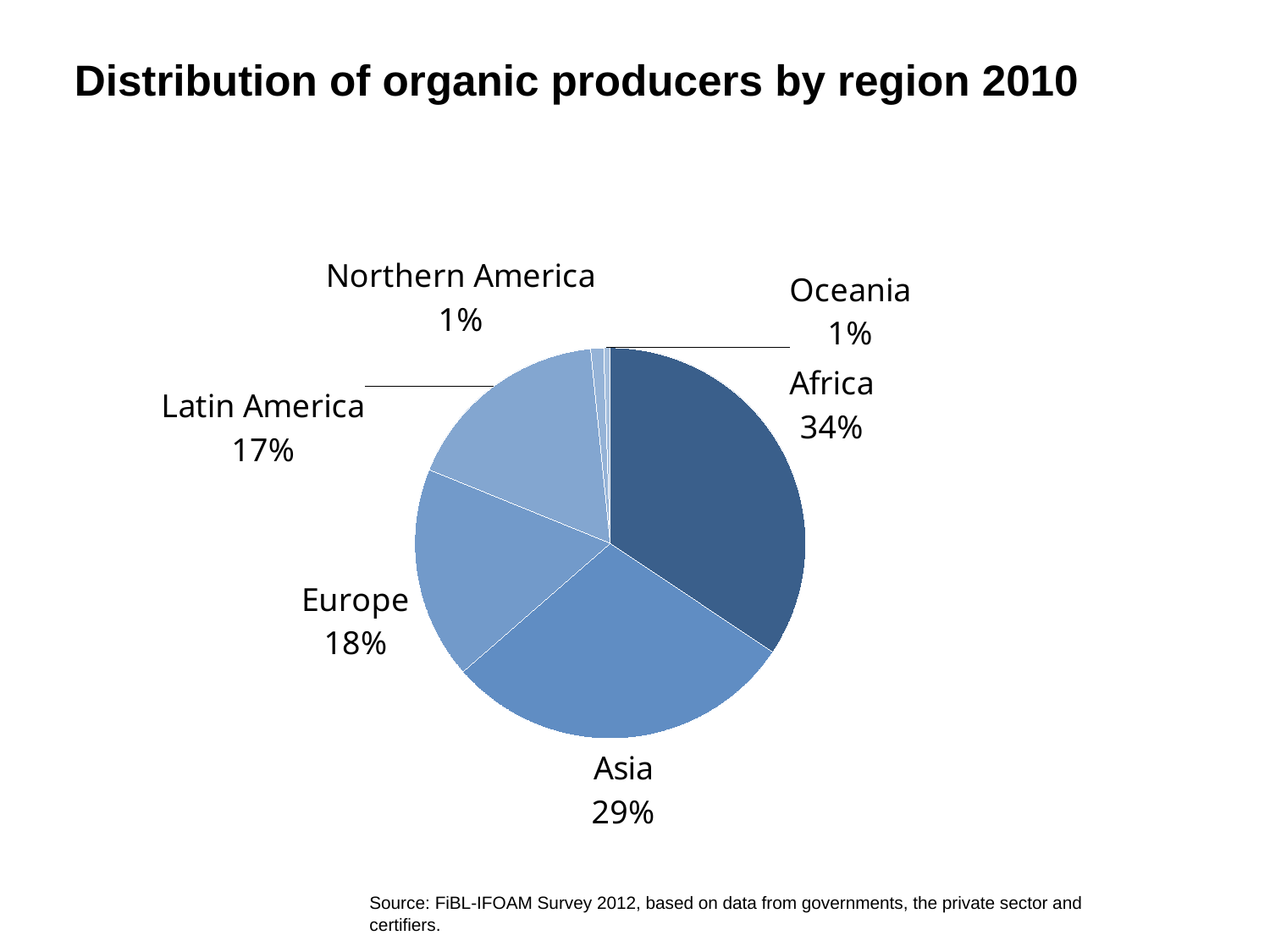
Which region has the largest share of organic producers? Africa How many regions are shown in the pie chart? 6 What is the title of the chart? Distribution of organic producers by region 2010 What share of organic producers is in Europe? 18% What share of organic producers is in Oceania? 1% What share of organic producers is in Africa? 34% What is the combined share of Europe and Latin America? 35% Which has a larger share of organic producers, Europe or Asia? Asia What share of organic producers is in Asia? 29% What is the difference in percentage points between the shares of Africa and Asia? 5 What share of organic producers is in Latin America? 17% What kind of chart is shown on the slide? Pie chart